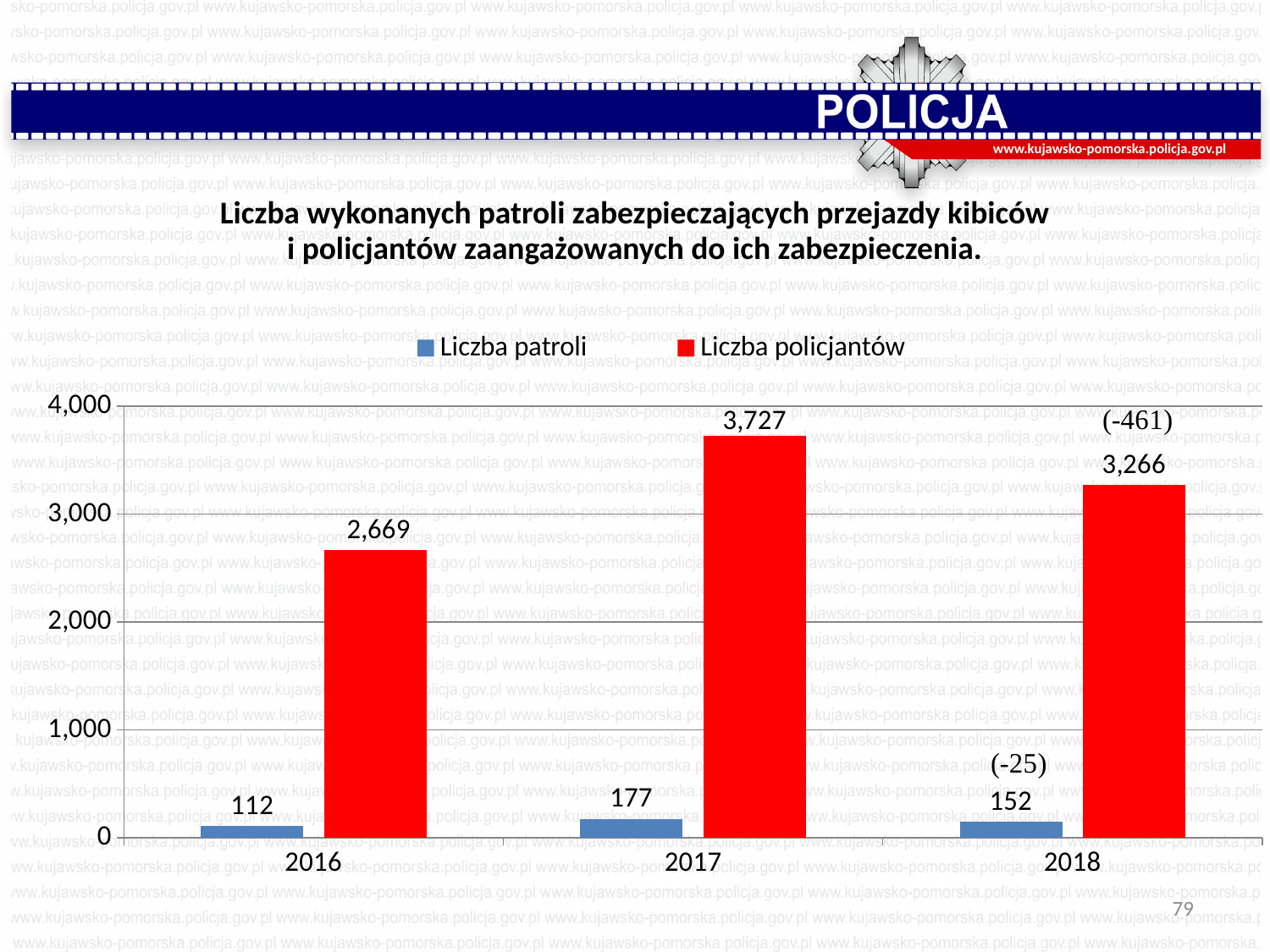
What is the value of Liczba patroli for 2016? 112 How many series does the legend list? 2 Which is larger: Liczba policjantów in 2016 or in 2018? 2018 What is the difference between Liczba patroli in 2017 and 2016? 65 Is the value for Liczba policjantów in 2016 greater or less than 3,000? less What is the difference between Liczba policjantów in 2017 and 2018? 461 What is the value of Liczba patroli for 2018? 152 What kind of chart is shown on the slide? bar chart What is the value of Liczba policjantów for 2018? 3,266 Which year has the highest value for Liczba policjantów? 2017 What is the value of Liczba policjantów for 2017? 3,727 Which year has the lowest value for Liczba patroli? 2016